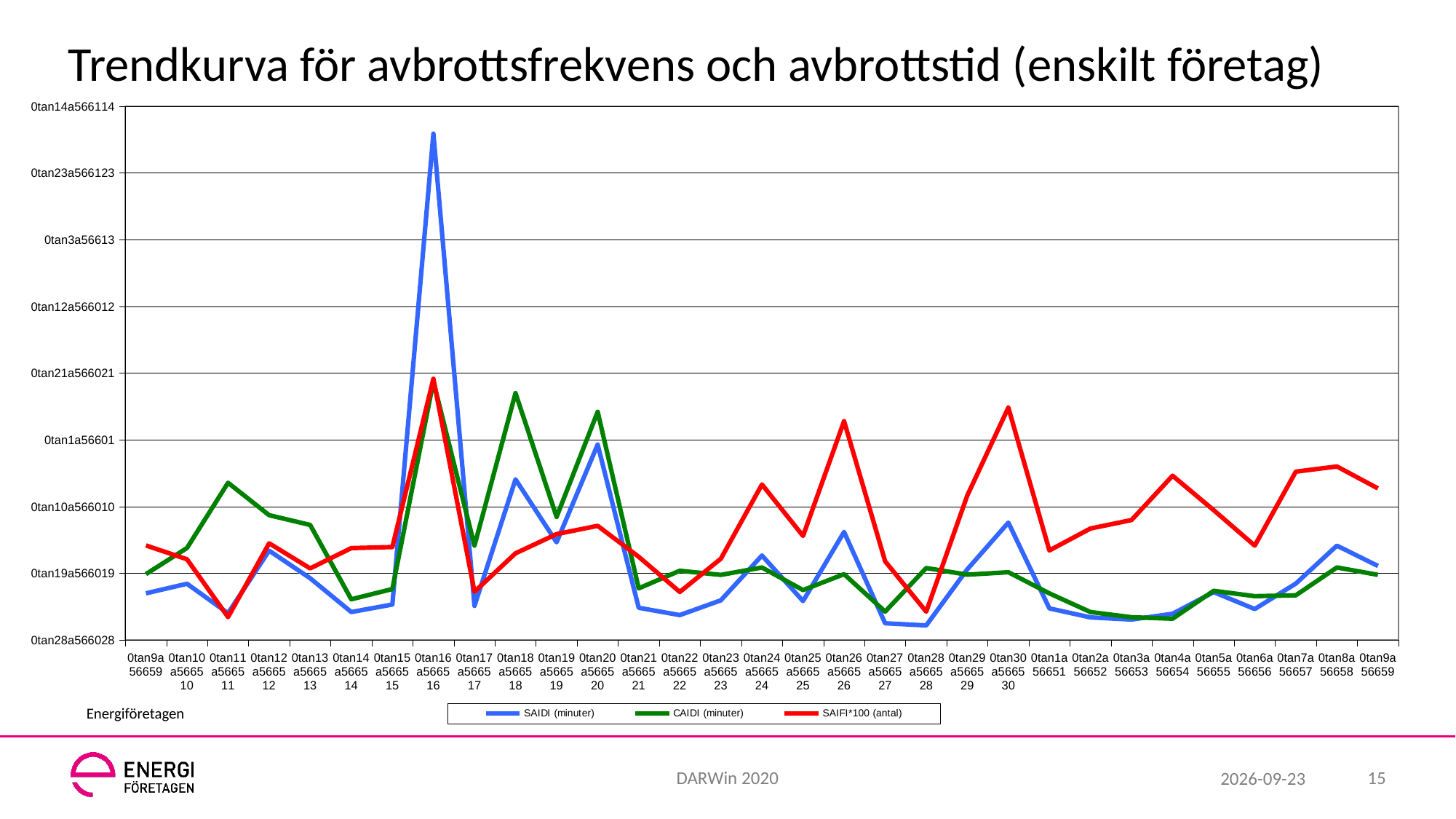
Does the SAIFI*100 (antal) line generally rise or fall from 0tan21 a5665 21 to 0tan26 a5665 26? rise At which x-axis category does the SAIDI (minuter) line reach its highest value? 0tan16 a5665 16 At the x-axis category 0tan30 a5665 30, which is larger: SAIFI*100 (antal) or CAIDI (minuter)? SAIFI*100 (antal) Which series reaches the highest peak on the chart? SAIDI (minuter) Does the SAIDI (minuter) line rise or fall from 0tan16 a5665 16 to 0tan17 a5665 17? fall How many points are plotted along the x axis for each series? 31 How many series does the legend list? 3 At the x-axis category 0tan18 a5665 18, which is larger: CAIDI (minuter) or SAIFI*100 (antal)? CAIDI (minuter) What kind of chart is shown on the slide? line chart What is the title of the chart? Trendkurva för avbrottsfrekvens och avbrottstid (enskilt företag) Which colour is used for the SAIDI (minuter) series? blue At the x-axis category 0tan16 a5665 16, which is larger: SAIDI (minuter) or SAIFI*100 (antal)? SAIDI (minuter)